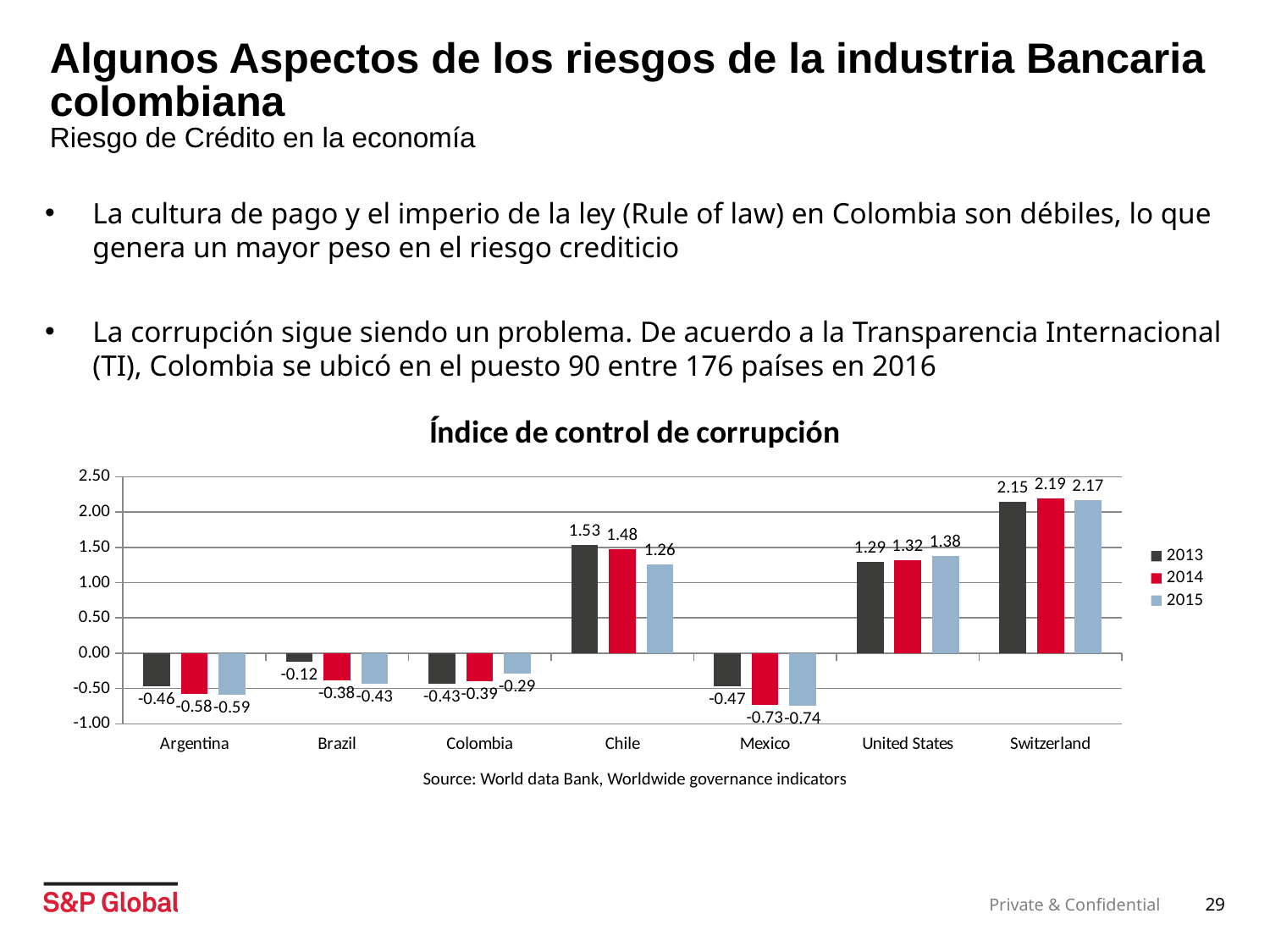
What is the difference between the 2015 values for Switzerland and the United States? 0.79 How many countries are shown on the x axis? 7 How many series does the legend list? 3 Which country has the highest 2015 value? Switzerland What is the 2014 value for Mexico? -0.73 What is the 2013 value for Chile? 1.53 Is the 2014 value for Switzerland greater or less than 2.00? greater What is the title of the chart? Índice de control de corrupción Which country has the lowest 2014 value? Mexico What is the 2015 value for Colombia in the Índice de control de corrupción chart? -0.29 What kind of chart is shown on the slide? bar chart Which is larger, the 2013 value for Chile or the 2013 value for the United States? Chile